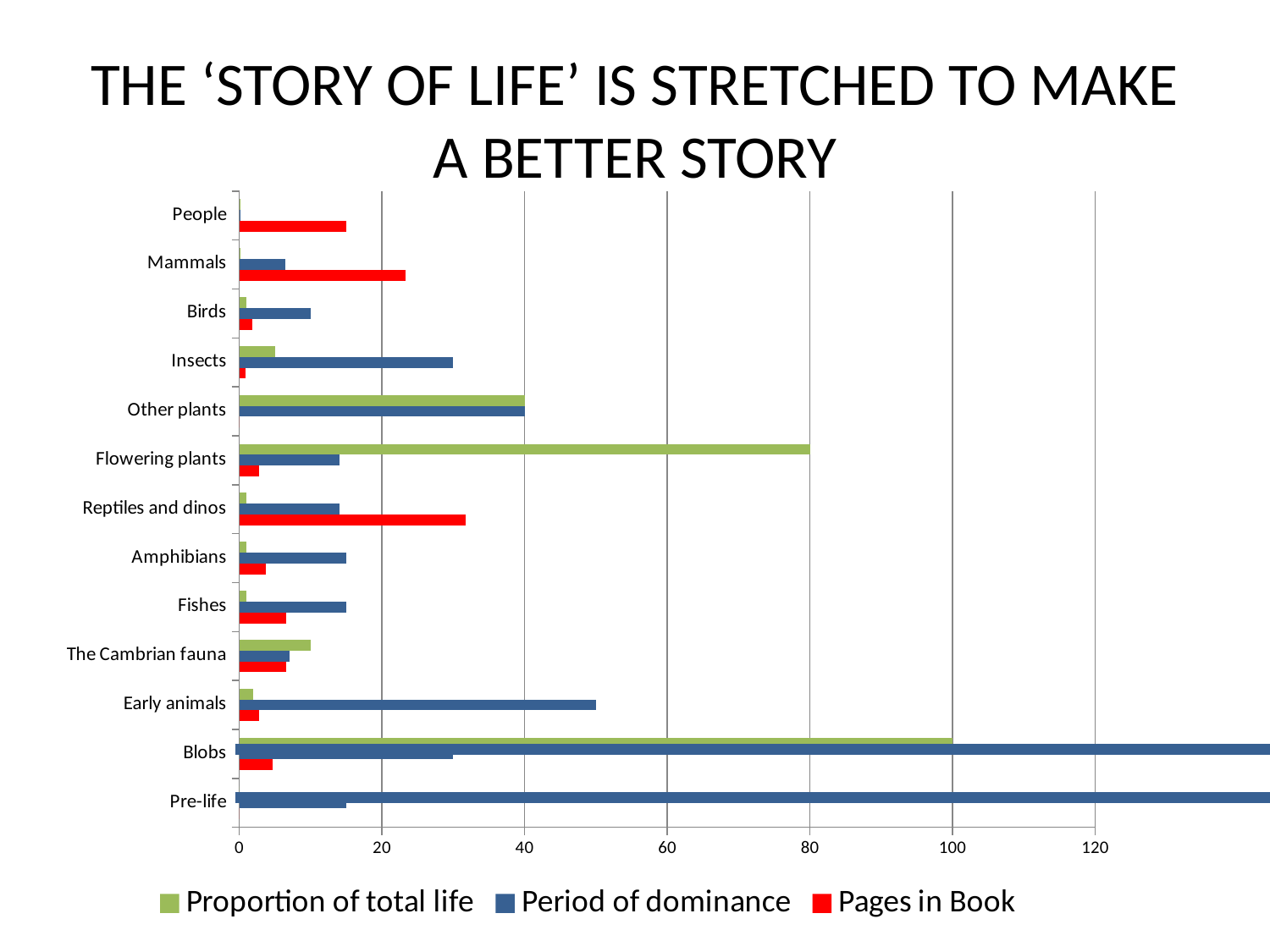
What is the Proportion of total life value for Other plants? 40 Which series is shown in red in the legend? Pages in Book How many series does the legend list? 3 Is the Period of dominance value for Early animals greater or less than 40? greater What kind of chart is shown on the slide? bar chart What is the difference between the Proportion of total life for Flowering plants and for Other plants? 40 Which category has the highest Proportion of total life? Blobs How many categories are shown on the vertical axis of the chart? 13 Is the Pages in Book value for Mammals greater or less than 40? less Which category has the highest Pages in Book value? Reptiles and dinos What is the Proportion of total life value for Blobs? 100 What is the Proportion of total life value for Flowering plants? 80